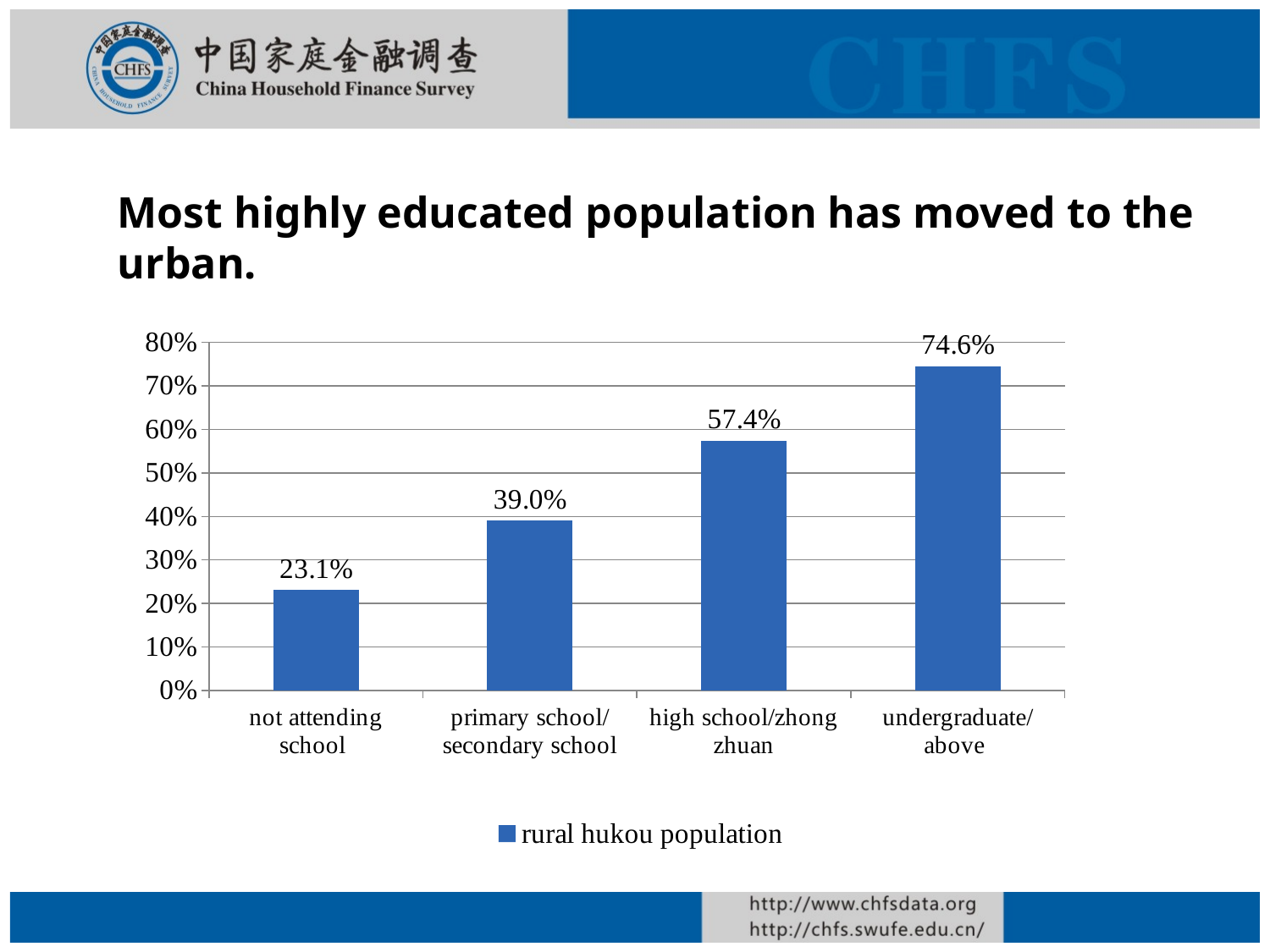
Which category has the lowest value? not attending school Which category has the highest value? undergraduate/above Do the values rise or fall from left to right along the x axis? rise What is the difference between the values for 'undergraduate/above' and 'not attending school'? 51.5% Is the value for 'primary school/secondary school' greater or less than 40%? less What is the value for the 'high school/zhong zhuan' category? 57.4% What is the value for the 'undergraduate/above' category? 74.6% Which is larger, the value for 'primary school/secondary school' or the value for 'high school/zhong zhuan'? high school/zhong zhuan How many categories are shown on the x axis? 4 What is the value for the 'not attending school' category? 23.1% What kind of chart is shown on the slide? bar chart What is the difference between the values for 'high school/zhong zhuan' and 'primary school/secondary school'? 18.4%